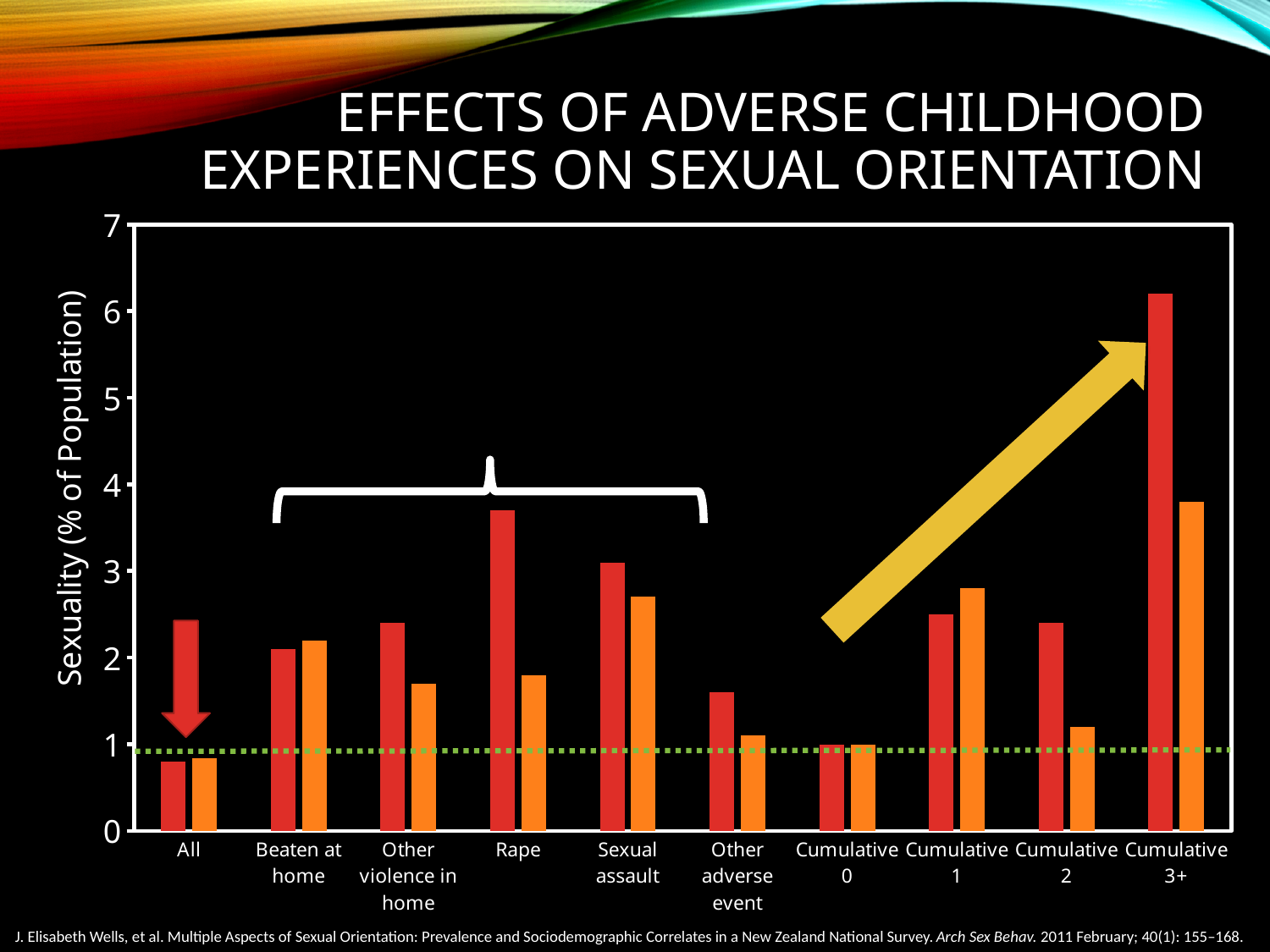
Is the orange bar for Sexual assault greater or less than 2? greater Which category has the tallest orange bar in the chart? Cumulative 3+ Which is larger, the red bar for Rape or the red bar for Sexual assault? Rape Is the red bar for All greater or less than 1? less Which category has the tallest red bar in the chart? Cumulative 3+ Is the red bar for Rape greater or less than 3? greater How many categories are shown along the x axis of the chart? 10 What kind of chart is shown on the slide? bar chart What is the title of the vertical axis of the chart? Sexuality (% of Population) Do the red bars rise or fall from Cumulative 0 to Cumulative 3+? rise What is the highest value shown on the vertical axis of the chart? 7